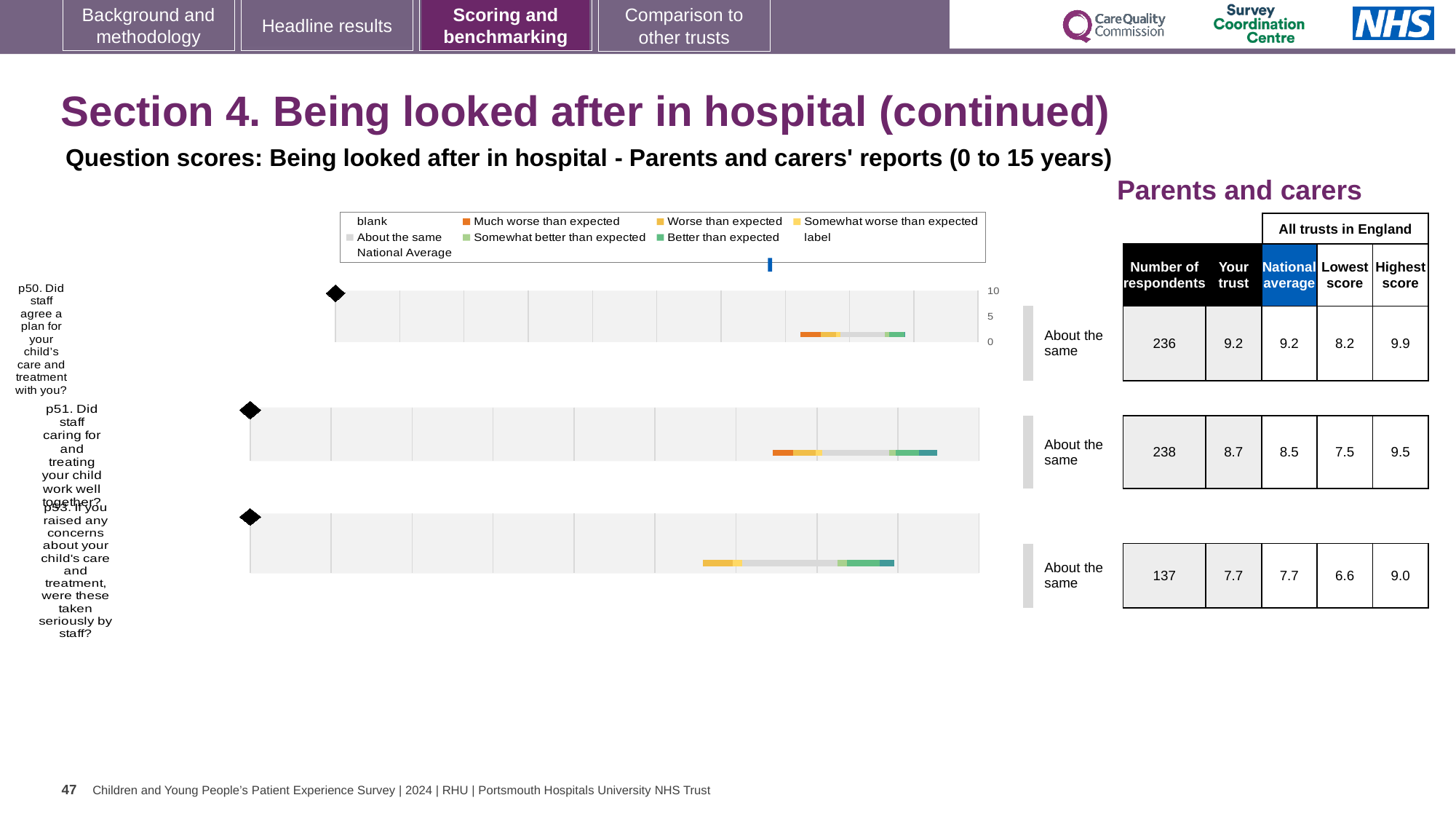
Which question has the largest number of respondents? p51 How many respondents are shown for question p50 (Did staff agree a plan for your child's care and treatment with you?)? 236 What is the lowest score among all trusts in England for question p51? 7.5 How many questions are plotted on this slide? 3 What is the 'Your trust' score for question p51 (Did staff caring for and treating your child work well together?)? 8.7 What is the national average score for question p53 (If you raised any concerns about your child's care and treatment, were these taken seriously by staff?)? 7.7 For question p53, what is the difference between the highest score and the lowest score among all trusts in England? 2.4 What benchmark category is shown for question p53? About the same What is the highest score among all trusts in England for question p50? 9.9 Which has the higher 'Your trust' score, question p50 or question p53? p50 For question p51, how much higher is the 'Your trust' score than the national average? 0.2 Which question has the lowest 'Your trust' score? p53